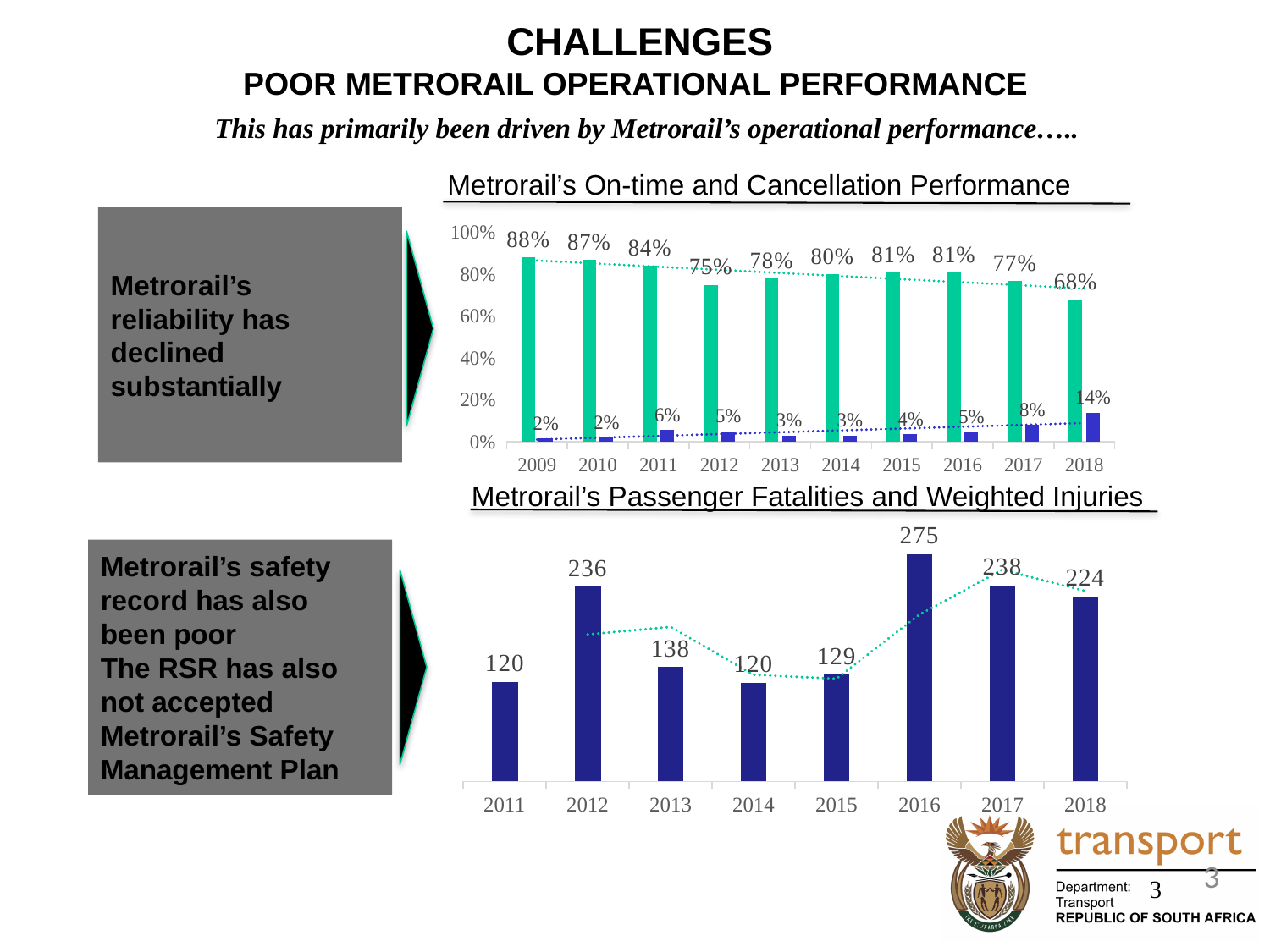
In the 'Metrorail's On-time and Cancellation Performance' chart, what is the value of the green bar for 2009? 88% In the 'Metrorail's On-time and Cancellation Performance' chart, what is the difference between the green bar values for 2009 and 2018? 20% In the 'Metrorail's On-time and Cancellation Performance' chart, how many years are shown on the x axis? 10 In the 'Metrorail's On-time and Cancellation Performance' chart, what is the value of the green bar for 2018? 68% In the 'Metrorail's Passenger Fatalities and Weighted Injuries' chart, which is larger, the value for 2012 or the value for 2013? 2012 In the 'Metrorail's On-time and Cancellation Performance' chart, which year has the highest blue bar? 2018 What kind of chart is the 'Metrorail's Passenger Fatalities and Weighted Injuries' chart? bar chart In the 'Metrorail's Passenger Fatalities and Weighted Injuries' chart, what is the value for 2016? 275 In the 'Metrorail's On-time and Cancellation Performance' chart, what is the value of the blue bar for 2017? 8% In the 'Metrorail's On-time and Cancellation Performance' chart, do the green bar values generally rise or fall from 2009 to 2018? fall In the 'Metrorail's Passenger Fatalities and Weighted Injuries' chart, which year has the lowest value? 2011 and 2014 In the 'Metrorail's Passenger Fatalities and Weighted Injuries' chart, what is the difference between the values for 2017 and 2018? 14